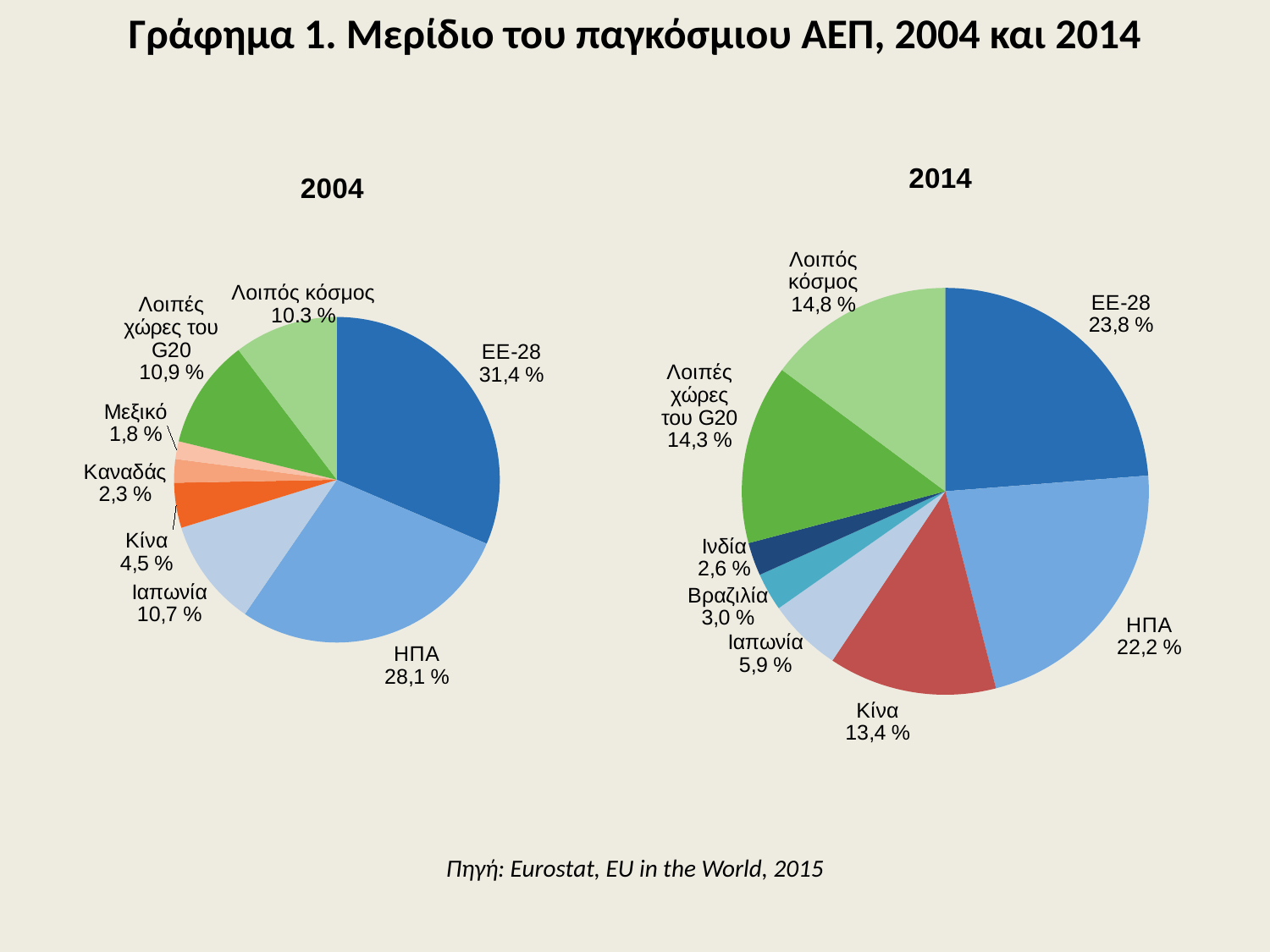
In the 2014 pie chart, which category has the smallest share? Ινδία In the 2004 pie chart, which category has the smallest share? Μεξικό What is the difference between the ΕΕ-28 share in 2004 and in 2014? 7,6 % How many slices does the 2004 pie chart have? 8 In the 2014 pie chart, what share does Κίνα have? 13,4 % In the 2014 pie chart, which is larger: Ιαπωνία or Κίνα? Κίνα What type of chart is used for the 2014 data? Pie chart In the 2014 pie chart, what is the value for Βραζιλία? 3,0 % What is the source cited at the bottom of the slide? Eurostat, EU in the World, 2015 In the 2004 pie chart, what share of world GDP does ΕΕ-28 have? 31,4 % In the 2014 pie chart, which category has the largest share? ΕΕ-28 In the 2004 pie chart, which category has the largest share? ΕΕ-28